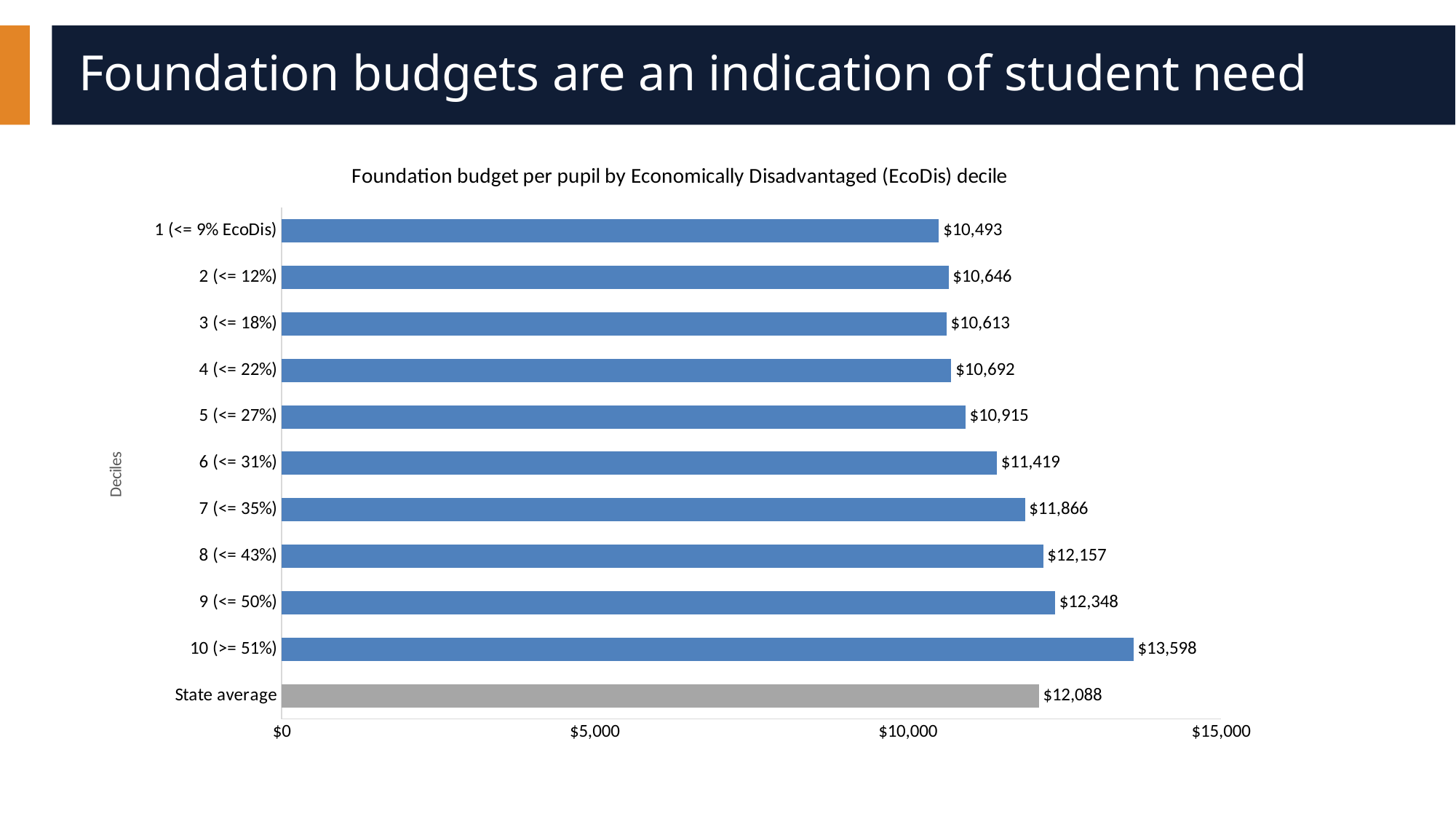
Which is larger, the foundation budget per pupil for decile 8 (<= 43%) or the State average? 8 (<= 43%) What is the foundation budget per pupil for decile 6 (<= 31%)? $11,419 What is the difference between the foundation budget per pupil for decile 10 (>= 51%) and decile 1 (<= 9% EcoDis)? $3,105 What kind of chart is shown on the slide? Bar chart What is the foundation budget per pupil for decile 1 (<= 9% EcoDis)? $10,493 What is the foundation budget per pupil for decile 10 (>= 51%)? $13,598 What is the State average foundation budget per pupil? $12,088 What is the difference between the State average and the value for decile 9 (<= 50%)? $260 Which category has the lowest foundation budget per pupil? 1 (<= 9% EcoDis) How many bars are shown in the chart? 11 Which category has the highest foundation budget per pupil? 10 (>= 51%) What is the title of the chart? Foundation budget per pupil by Economically Disadvantaged (EcoDis) decile